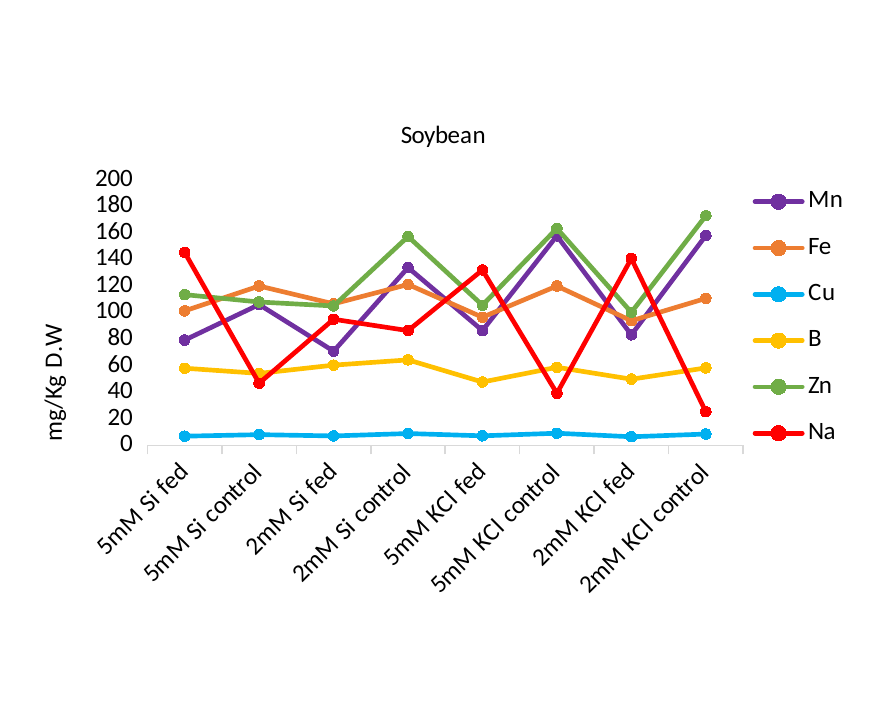
Is the Na value for 2mM KCl control greater or less than 40? less What kind of chart is shown on the slide? line chart How many series does the legend list? 6 How many categories are shown along the x axis? 8 At 2mM KCl control, which is larger, Zn or Fe? Zn Is the Cu value for 5mM Si fed greater or less than 20? less Which series has the lowest values across all categories? Cu Is the Na value for 5mM Si fed greater or less than 120? greater What is the label on the y axis? mg/Kg D.W What is the title of the chart? Soybean Which category has the lowest Na value? 2mM KCl control